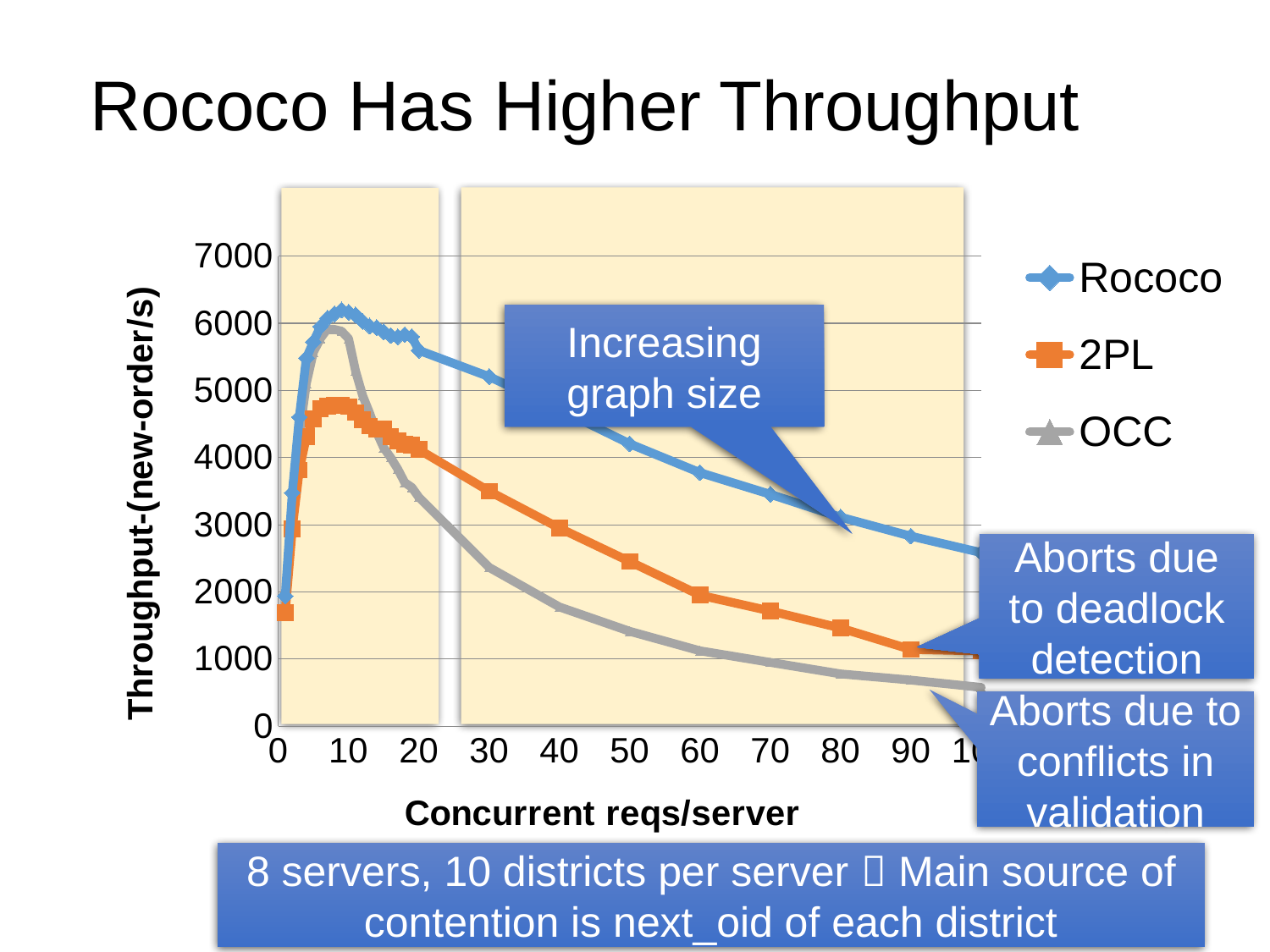
Is the peak throughput of 2PL greater or less than 5000? less At 50 concurrent reqs/server, which has higher throughput, Rococo or 2PL? Rococo Which series has the lowest throughput at 80 concurrent reqs/server? OCC Does the throughput of Rococo rise or fall as concurrent reqs/server increases from 10 to 100? fall What is the title of the x axis? Concurrent reqs/server Which series reaches the highest throughput? Rococo Which series are listed in the legend? Rococo, 2PL, OCC Is the peak throughput of Rococo greater or less than 6000? greater Is the throughput of OCC at 80 concurrent reqs/server greater or less than 1000? less What kind of chart is shown on the slide? line chart How many series does the legend list? 3